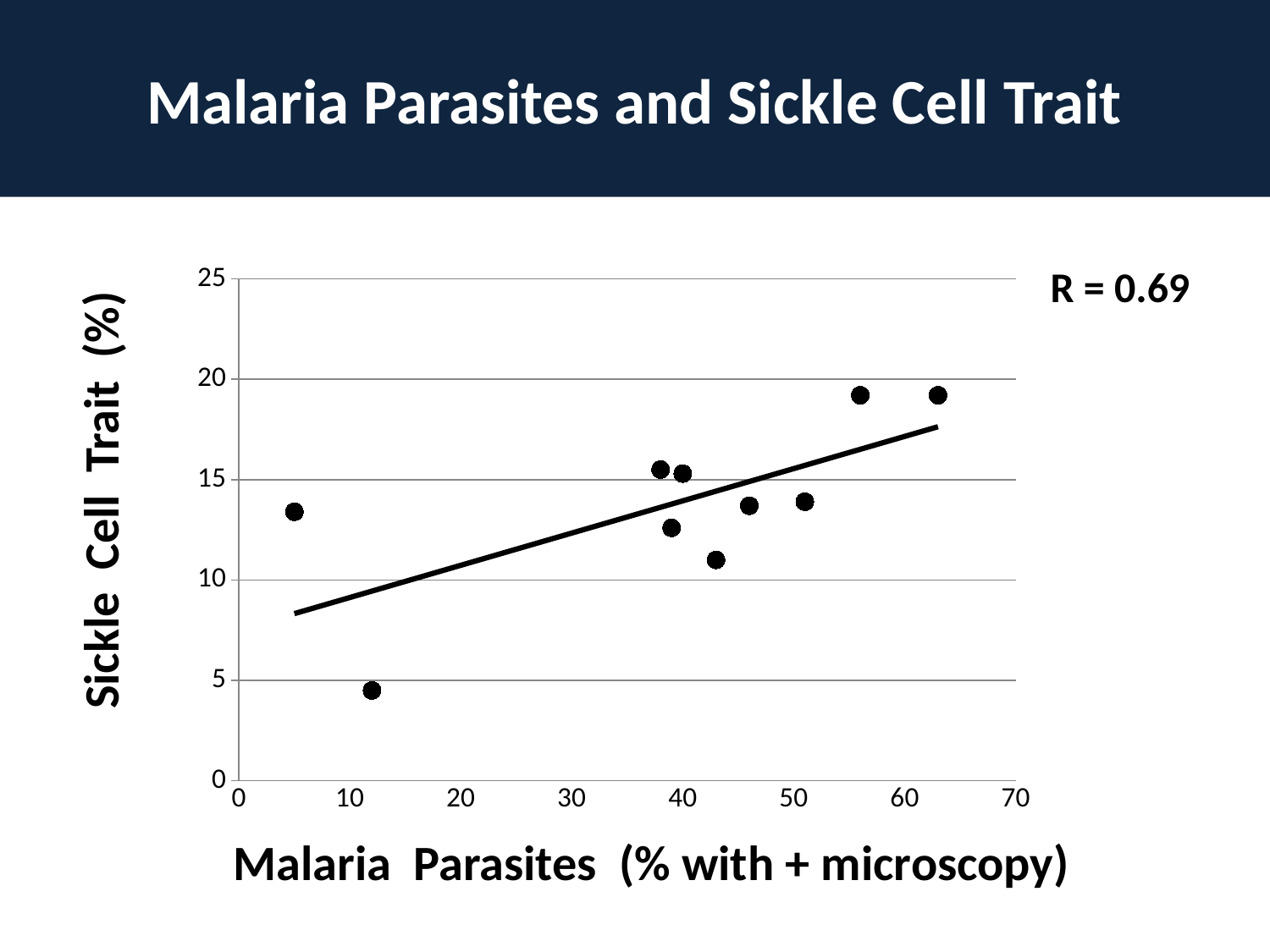
What correlation coefficient (R) is shown on the chart? R = 0.69 How many plotted points have a Sickle Cell Trait value below 5? 1 What kind of chart is shown on the slide? Scatter plot What is the title of the chart? Malaria Parasites and Sickle Cell Trait Are the two highest plotted points greater or less than 20 on the Sickle Cell Trait axis? less How many data points are plotted on the chart? 10 Does the trend line show Sickle Cell Trait rising or falling as Malaria Parasites percentage increases? Rising Is the Sickle Cell Trait value for the point with the lowest Malaria Parasites percentage greater or less than 10? greater Is the Sickle Cell Trait value for the point with the highest Malaria Parasites percentage greater or less than 15? greater How many plotted points have a Sickle Cell Trait value above 20? 0